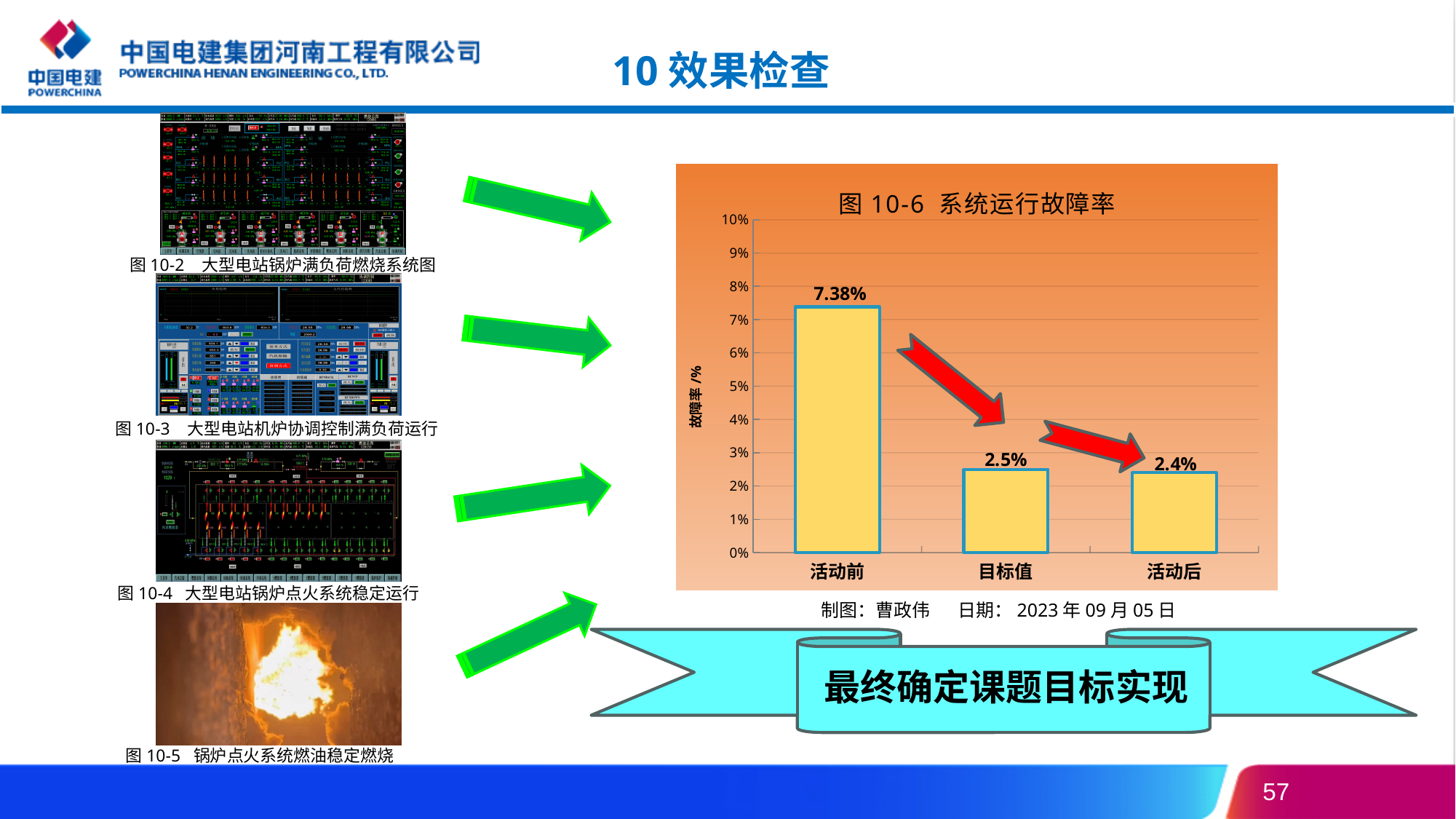
What is the y-axis label of the chart 图 10-6 系统运行故障率? 故障率 /% What is the difference between the values for 活动前 and 活动后 in the chart 图 10-6 系统运行故障率? 4.98% Which category has the lowest value in the chart 图 10-6 系统运行故障率? 活动后 Which category has the highest value in the chart 图 10-6 系统运行故障率? 活动前 What is the difference between the values for 目标值 and 活动后 in the chart 图 10-6 系统运行故障率? 0.1% What is the value for 活动后 in the chart 图 10-6 系统运行故障率? 2.4% Which is larger in the chart 图 10-6 系统运行故障率: the value for 活动前 or the value for 目标值? 活动前 What is the value for 活动前 in the chart 图 10-6 系统运行故障率? 7.38% What kind of chart is 图 10-6 系统运行故障率? bar chart What is the value for 目标值 in the chart 图 10-6 系统运行故障率? 2.5% How many categories are shown on the x axis of the chart 图 10-6 系统运行故障率? 3 Is the value for 活动前 in the chart 图 10-6 系统运行故障率 greater or less than 5%? greater